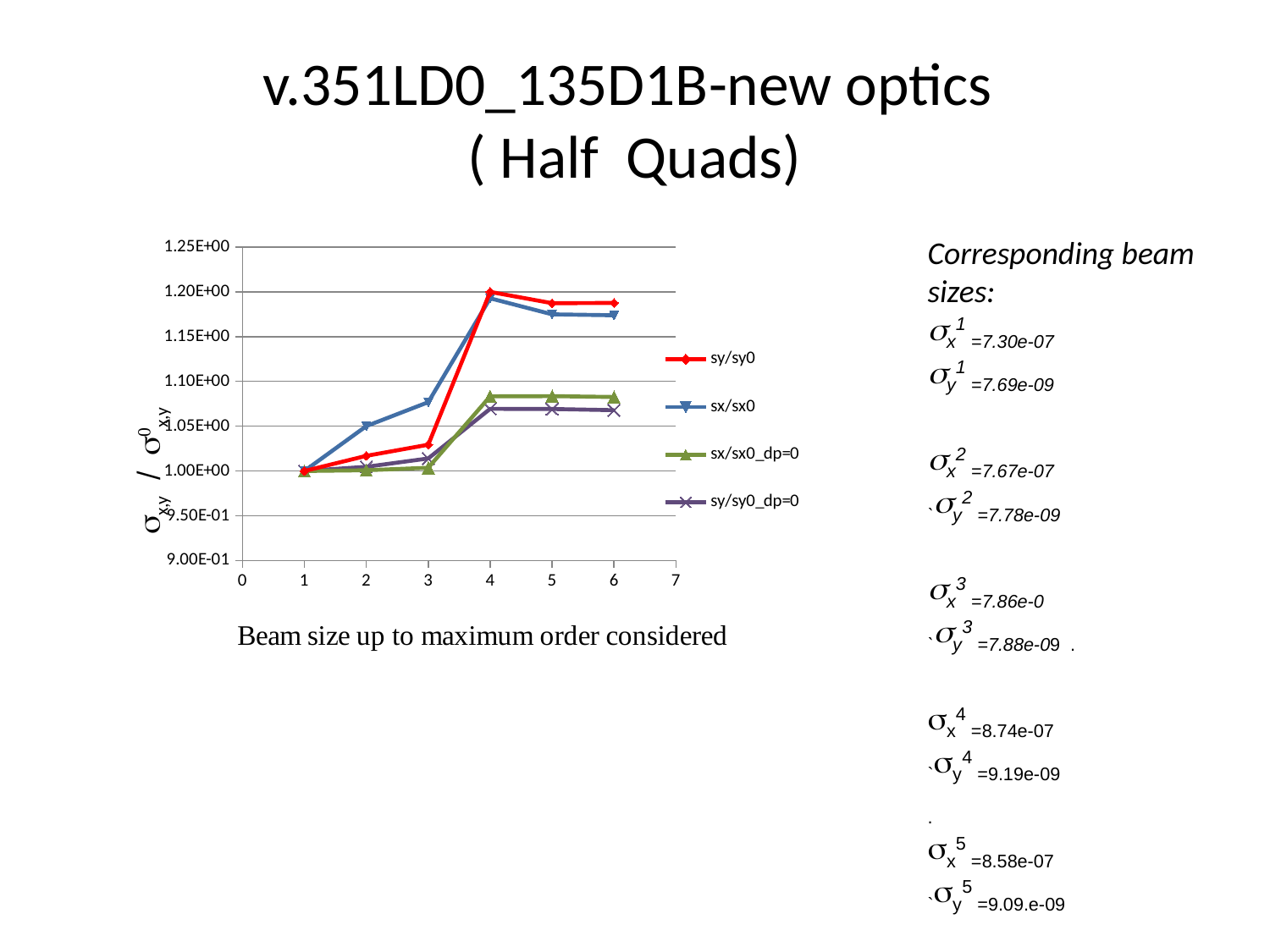
How many series does the chart legend list? 4 What is the caption written below the x axis of the chart? Beam size up to maximum order considered What is the highest tick value shown on the y axis of the chart? 1.25E+00 At x = 2, which series has the larger value, sx/sx0 or sy/sy0? sx/sx0 Does the sy/sy0 series rise or fall between x = 1 and x = 4? rise Is the value of sx/sx0_dp=0 at x = 5 greater or less than 1.10E+00? less At x = 5, which series has the larger value, sy/sy0 or sx/sx0_dp=0? sy/sy0 How many data points are plotted for the sy/sy0 series? 6 Is the value of sy/sy0_dp=0 at x = 6 greater or less than 1.10E+00? less Is the value of sx/sx0 at x = 2 greater or less than 1.00E+00? greater What kind of chart is shown on the slide? line chart